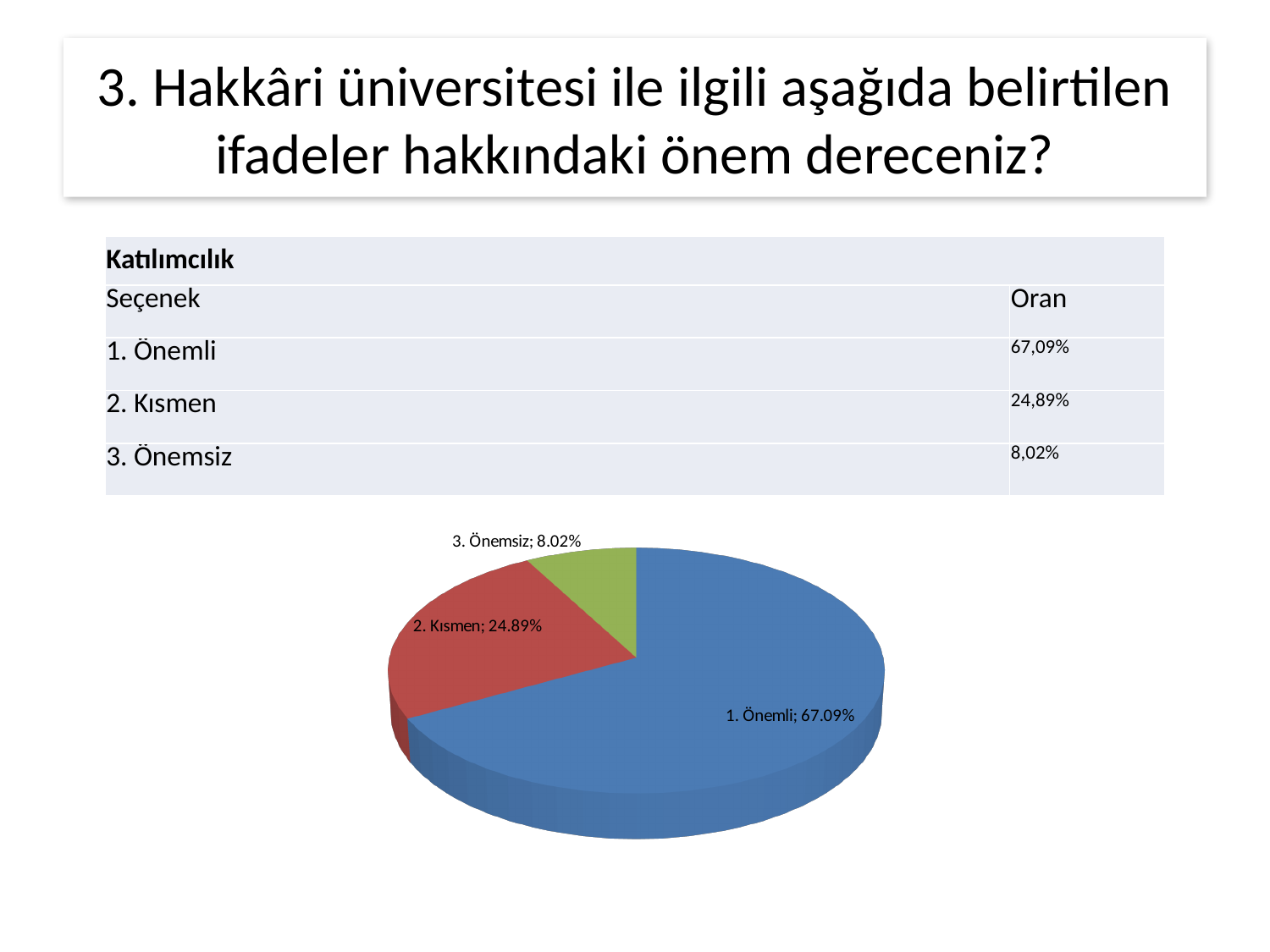
What kind of chart is shown on the slide? pie chart What is the difference in percentage points between the "1. Önemli" slice and the "2. Kısmen" slice? 42.20 What share of the pie does the slice labelled "2. Kısmen" represent? 24.89% What share of the pie does the slice labelled "3. Önemsiz" represent? 8.02% What share of the pie does the slice labelled "1. Önemli" represent? 67.09% What colour is the slice labelled "1. Önemli" in the pie chart? blue What is the difference in percentage points between the "2. Kısmen" slice and the "3. Önemsiz" slice? 16.87 How many slices does the pie chart have? 3 Which slice of the pie chart is the largest? 1. Önemli Which slice of the pie chart is the smallest? 3. Önemsiz What colour is the slice labelled "3. Önemsiz" in the pie chart? green Which is larger in the pie chart, the share for "2. Kısmen" or the share for "3. Önemsiz"? 2. Kısmen